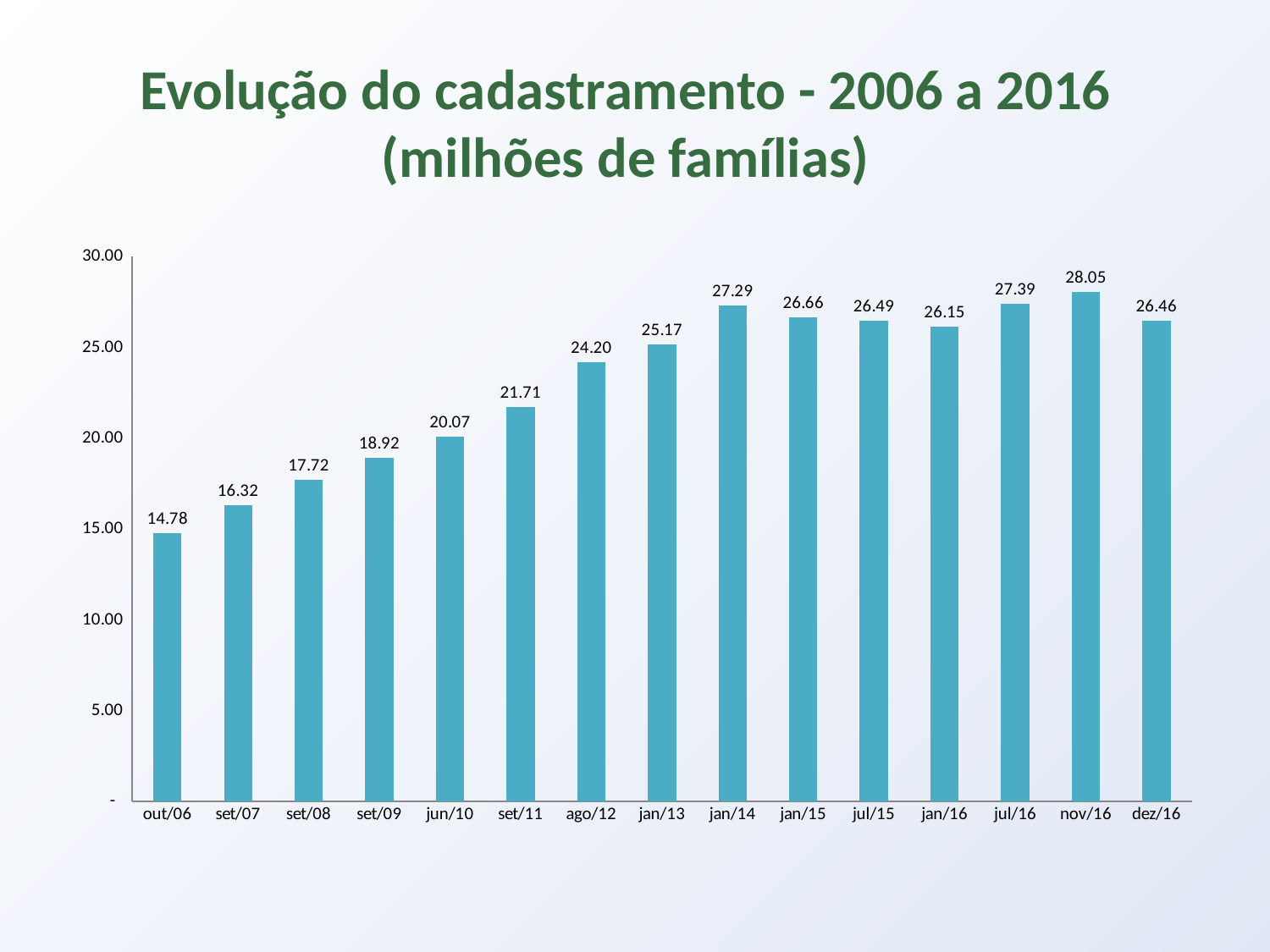
What is the value for dez/16? 26.46 What is the difference between the values for jan/14 and jan/13? 2.12 Which is larger, the value for jul/16 or the value for jan/16? jul/16 Is the value for set/09 greater or less than 20.00? less Which category has the lowest value? out/06 Which category has the highest value? nov/16 How many categories are shown on the x axis? 15 What is the difference between the values for nov/16 and out/06? 13.27 Do the values rise or fall from out/06 to jan/14? rise What is the value for jan/14? 27.29 What kind of chart is shown on the slide? bar chart What is the value for jun/10? 20.07